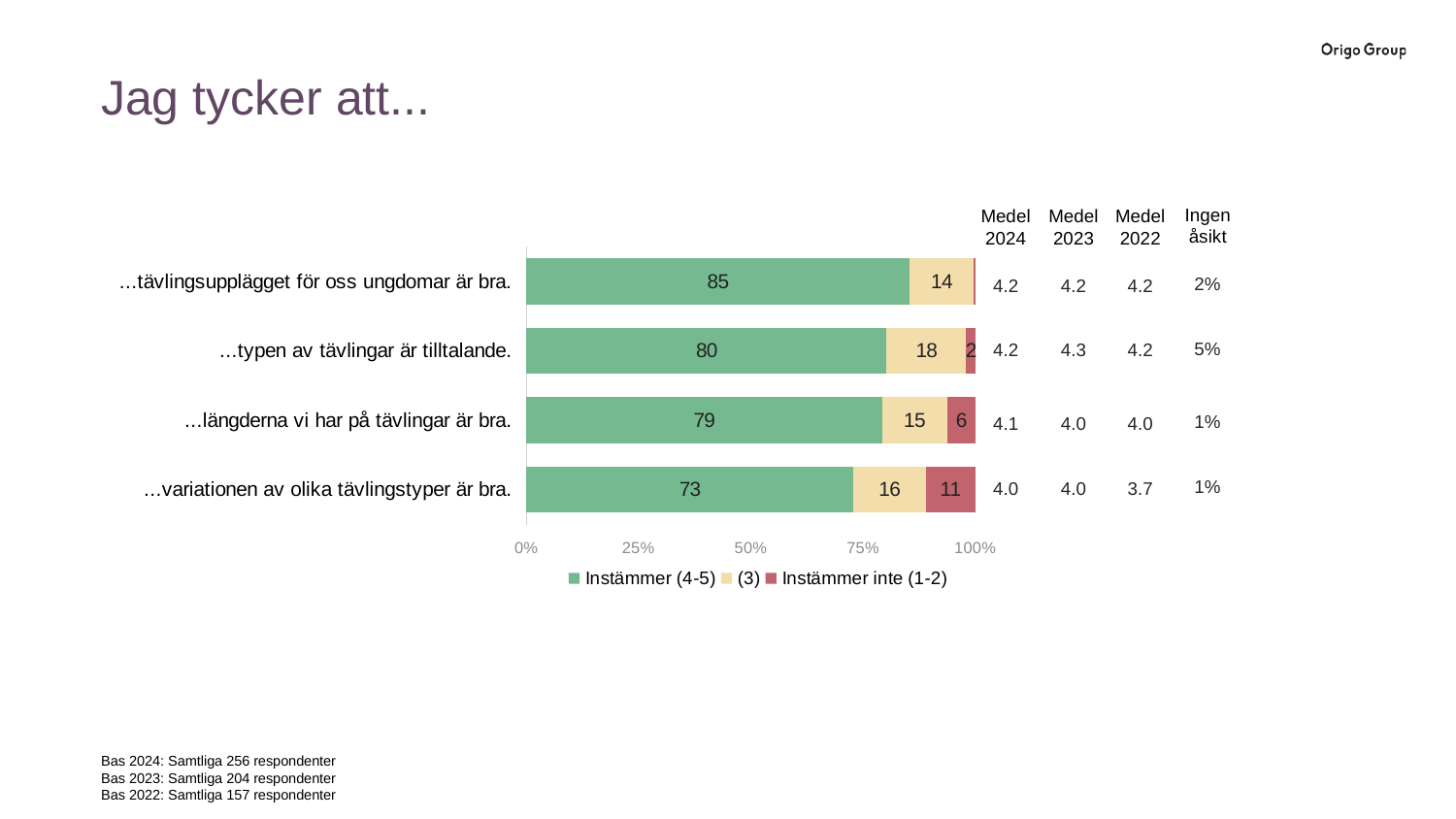
What is the difference between the 'Instämmer (4-5)' values for '...tävlingsupplägget för oss ungdomar är bra.' and '...variationen av olika tävlingstyper är bra.'? 12 What is the total of the stacked bar for '...variationen av olika tävlingstyper är bra.'? 100 Which statement has the lowest 'Instämmer (4-5)' value? ...variationen av olika tävlingstyper är bra. What is the 'Instämmer inte (1-2)' value for '...längderna vi har på tävlingar är bra.'? 6 What is the '(3)' value for '...typen av tävlingar är tilltalande.'? 18 What is the 'Instämmer (4-5)' value for '...tävlingsupplägget för oss ungdomar är bra.'? 85 Which is larger: the 'Instämmer inte (1-2)' value for '...typen av tävlingar är tilltalande.' or for '...längderna vi har på tävlingar är bra.'? ...längderna vi har på tävlingar är bra. What kind of chart is shown on the slide? bar chart How many categories (statements) are plotted in the chart? 4 What is the 'Instämmer inte (1-2)' value for '...variationen av olika tävlingstyper är bra.'? 11 How many series does the legend list? 3 Which statement has the highest 'Instämmer (4-5)' value? ...tävlingsupplägget för oss ungdomar är bra.